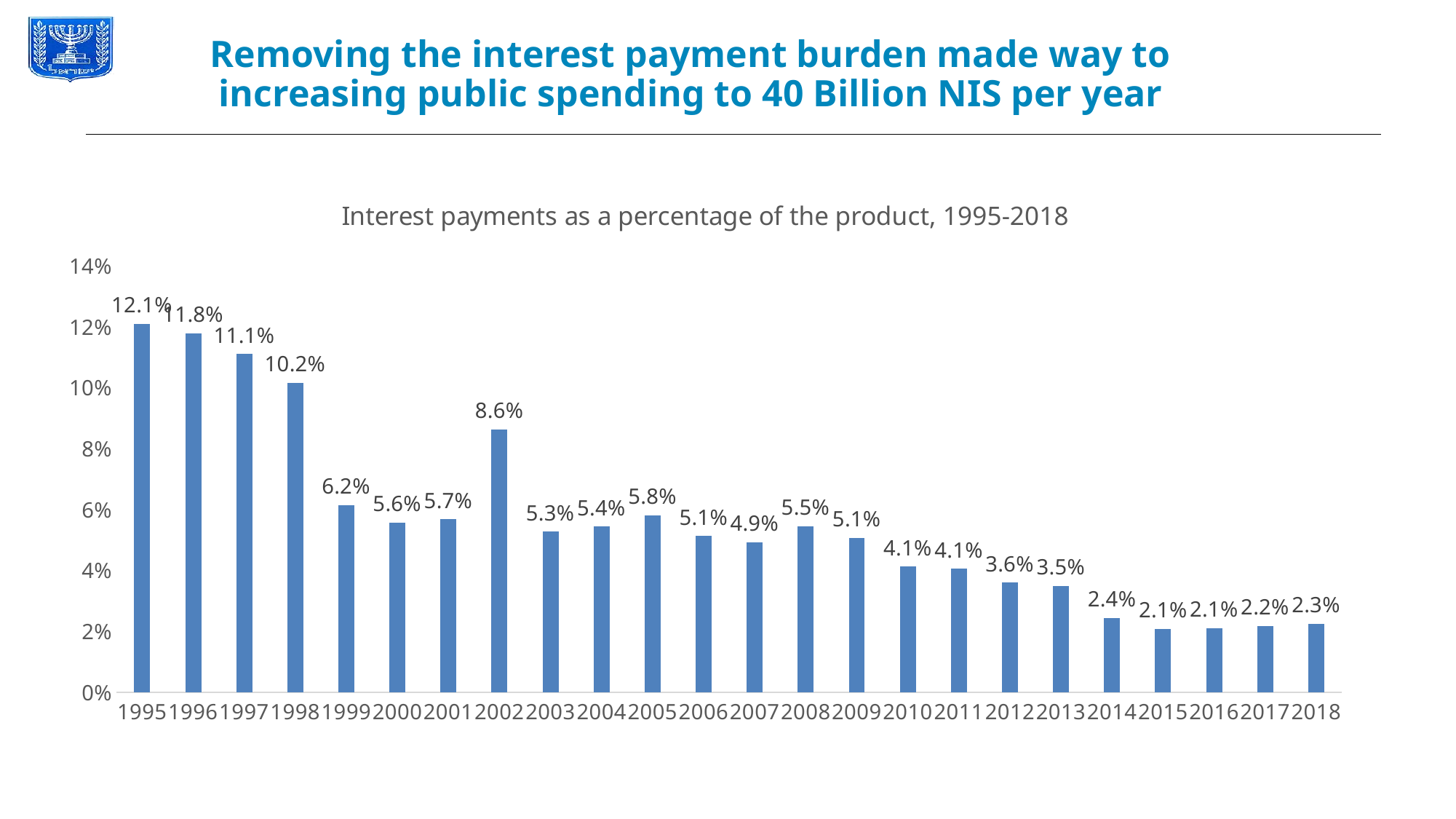
What is the value for 2018? 2.3% Is the value for 2002 greater or less than 8%? greater What kind of chart is this? bar chart What is the difference between the values for 1998 and 1999? 4.0% What is the value for 2009? 5.1% What is the value for 1995? 12.1% What is the difference between the values for 1995 and 2018? 9.8% Which year has the highest value? 1995 What is the value for 2002? 8.6% What is the title of the chart? Interest payments as a percentage of the product, 1995-2018 How many years are shown on the x axis? 24 Which is larger, the value for 2005 or the value for 2008? 2005